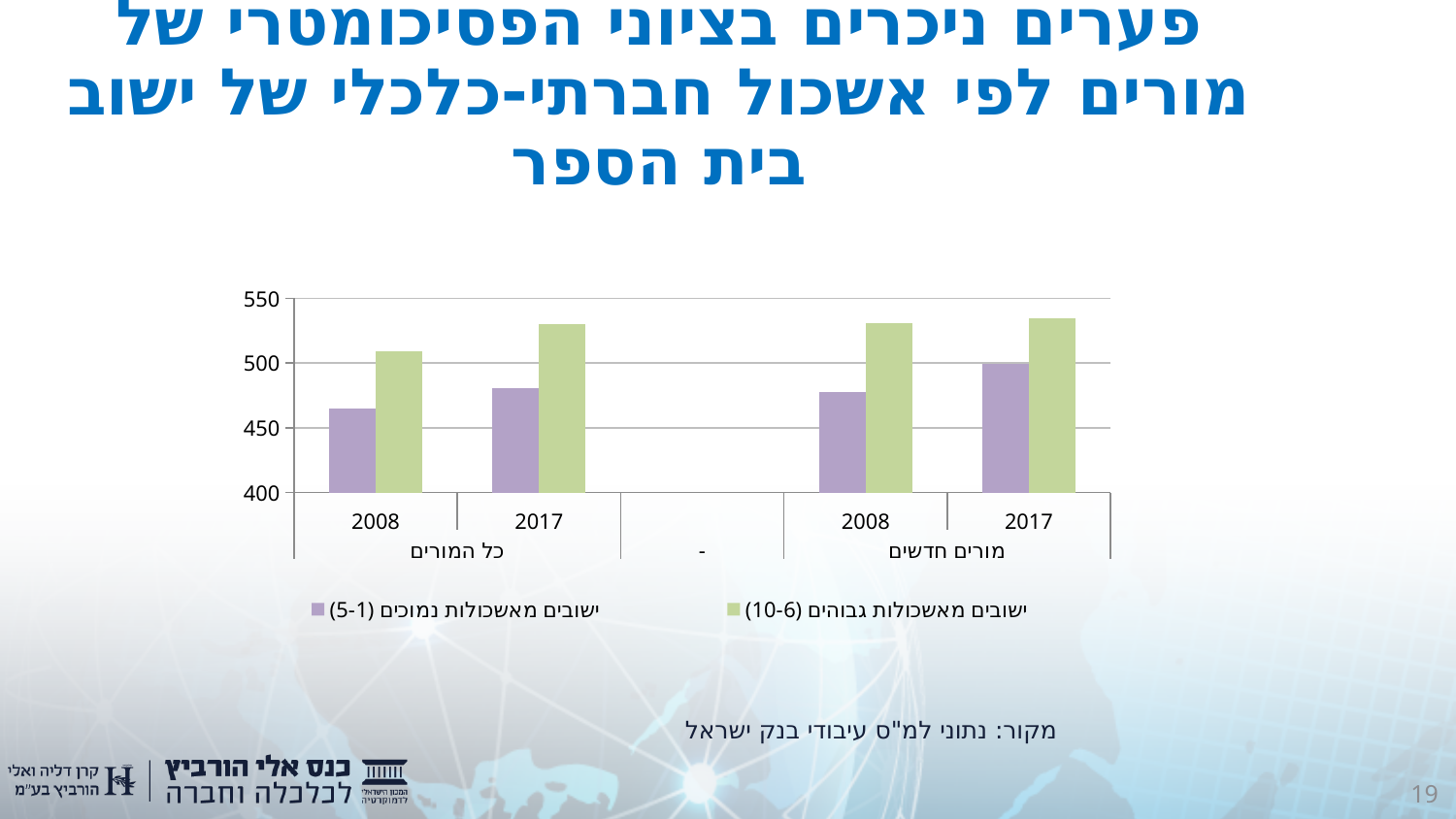
For מורים חדשים in 2017, which series has the larger value: ישובים מאשכולות נמוכים (1-5) or ישובים מאשכולות גבוהים (6-10)? ישובים מאשכולות גבוהים (6-10) What kind of chart is shown on the slide? bar chart Is the value for ישובים מאשכולות נמוכים (1-5) in 2008 for מורים חדשים greater or less than 500? less Is the value for ישובים מאשכולות נמוכים (1-5) in 2008 for כל המורים greater or less than 500? less How many series does the chart legend list? 2 How many bars are plotted in the chart in total? 8 Is the value for ישובים מאשכולות גבוהים (6-10) in 2008 for מורים חדשים greater or less than 500? greater For כל המורים, does the value for ישובים מאשכולות נמוכים (1-5) rise or fall from 2008 to 2017? rise Which series is shown in purple in the chart? ישובים מאשכולות נמוכים (5-1) Which series is shown in green in the chart? ישובים מאשכולות גבוהים (10-6) Which bar is the lowest in the chart? ישובים מאשכולות נמוכים (1-5), 2008, כל המורים